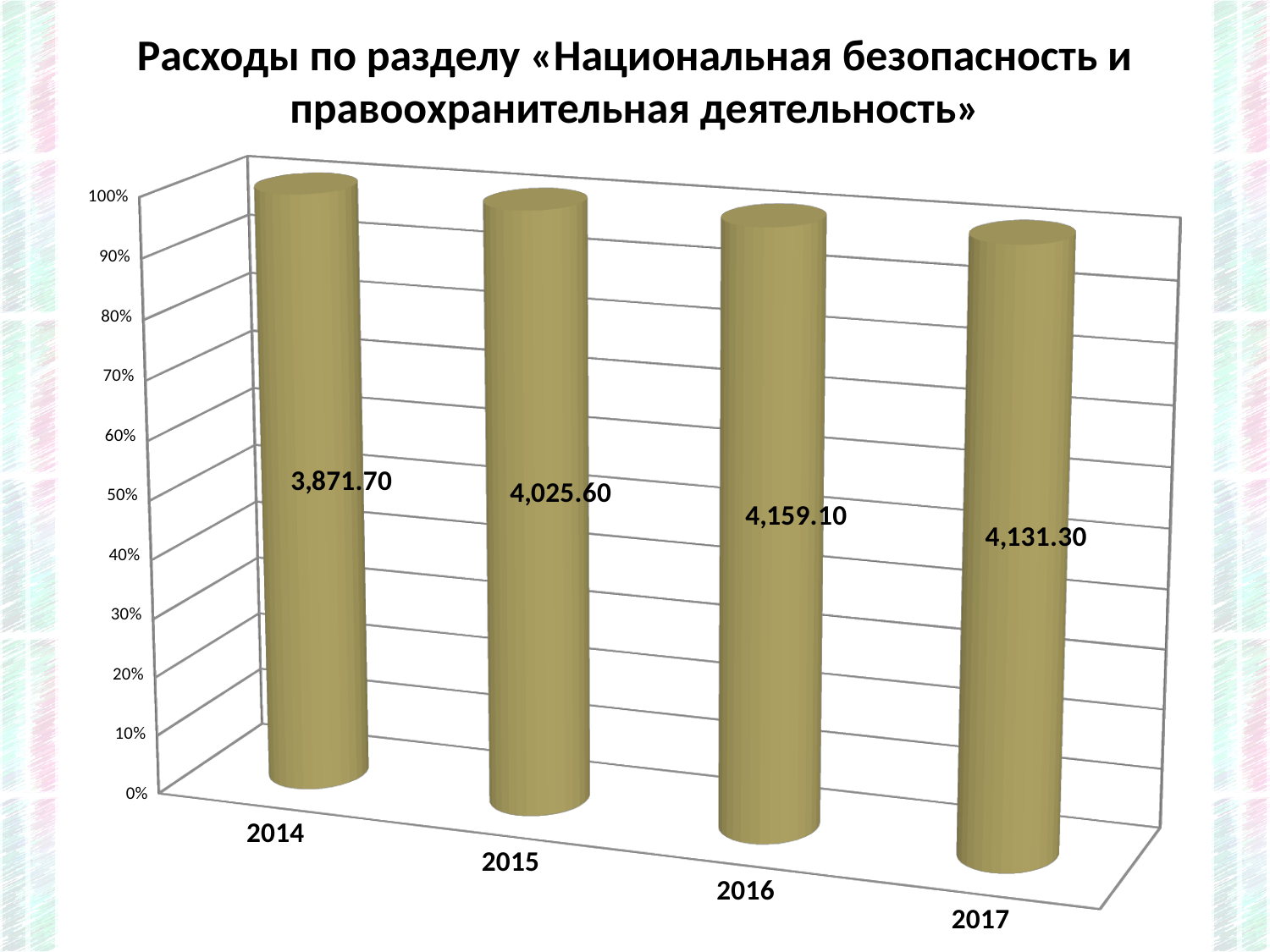
What is the title of the chart? Расходы по разделу «Национальная безопасность и правоохранительная деятельность» What is the data label for 2017? 4,131.30 How many years are shown on the x axis? 4 Which labelled value is larger, 2015 or 2017? 2017 Which year has the lowest labelled value? 2014 What is the difference between the labelled values for 2015 and 2014? 153.90 What is the difference between the labelled values for 2016 and 2017? 27.80 What kind of chart is shown on the slide? Bar chart Which year has the highest labelled value? 2016 What is the data label for 2014? 3,871.70 What is the data label for 2016? 4,159.10 What is the data label for 2015? 4,025.60